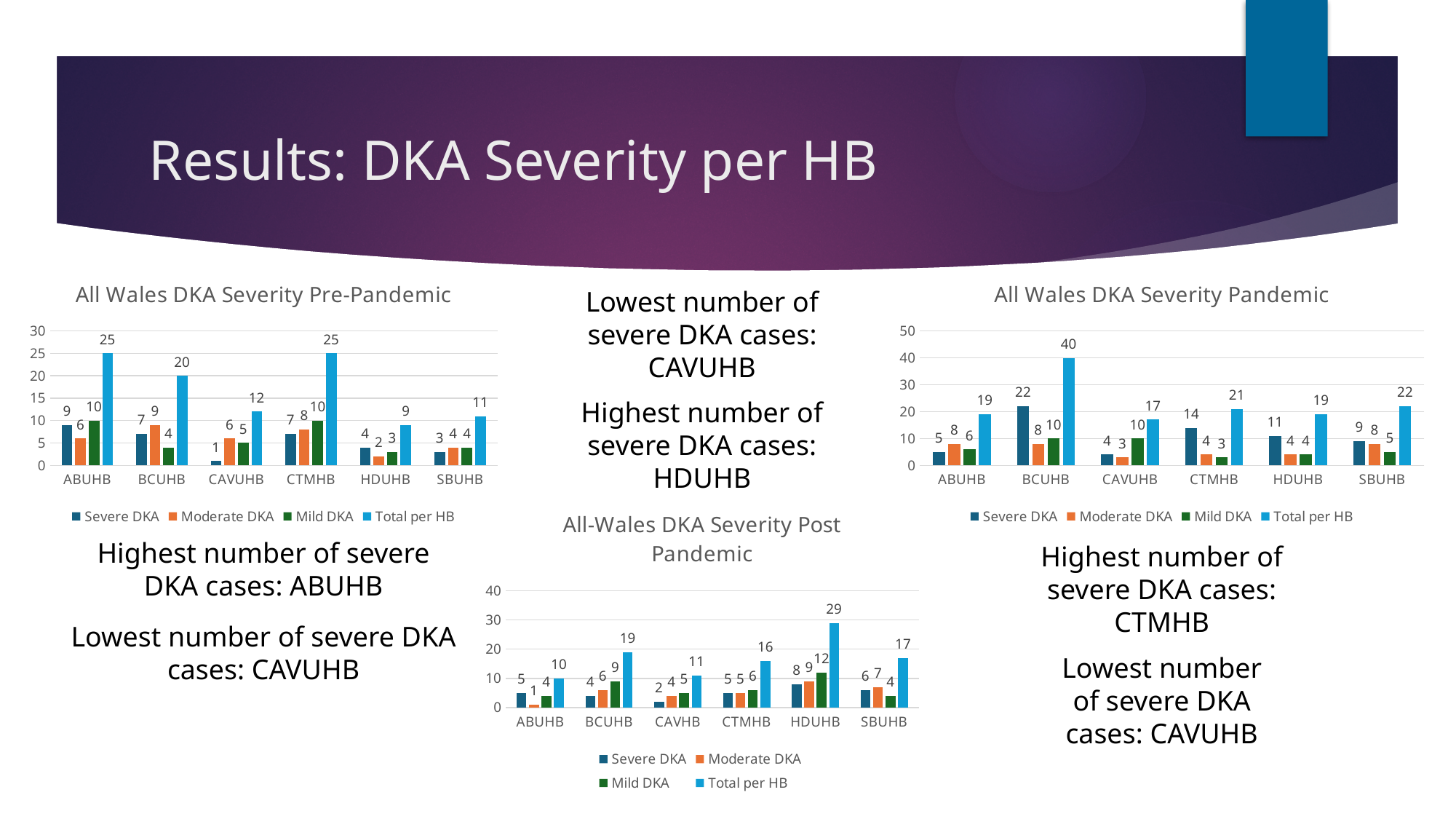
In the 'All Wales DKA Severity Pre-Pandemic' chart, which health board has the lowest Total per HB? HDUHB In the 'All-Wales DKA Severity Post Pandemic' chart, what is the Total per HB value for HDUHB? 29 In the 'All Wales DKA Severity Pandemic' chart, what is the Total per HB value for BCUHB? 40 In the 'All Wales DKA Severity Pandemic' chart, what is the Mild DKA value for CAVUHB? 10 In the 'All Wales DKA Severity Pre-Pandemic' chart, what is the Total per HB value for ABUHB? 25 In the 'All Wales DKA Severity Pre-Pandemic' chart, what is the difference between the Total per HB for BCUHB and CAVUHB? 8 In the 'All Wales DKA Severity Pre-Pandemic' chart, what is the Severe DKA value for CAVUHB? 1 In the 'All Wales DKA Severity Pandemic' chart, which health board has the highest Total per HB? BCUHB How many series does the legend of the 'All Wales DKA Severity Pre-Pandemic' chart list? 4 In the 'All-Wales DKA Severity Post Pandemic' chart, which health board has the lowest Total per HB? ABUHB In the 'All Wales DKA Severity Pandemic' chart, is the Severe DKA value for CTMHB larger or smaller than the Severe DKA value for HDUHB? larger How many health boards are shown on the x axis of the 'All-Wales DKA Severity Post Pandemic' chart? 6